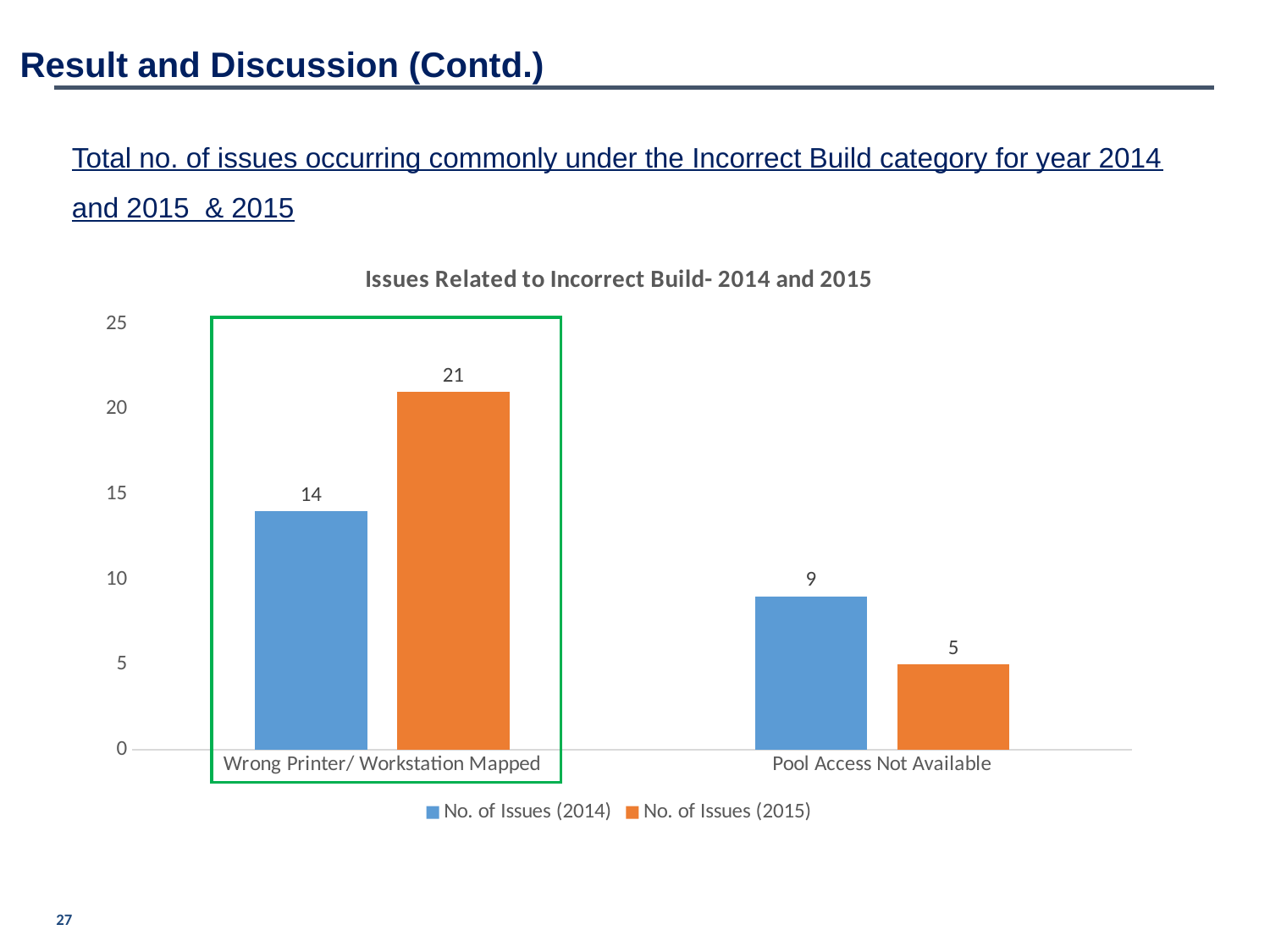
How many categories are shown on the x axis? 2 For Pool Access Not Available, which year had more issues, 2014 or 2015? 2014 What is the number of issues in 2014 for Pool Access Not Available? 9 What is the number of issues in 2015 for Pool Access Not Available? 5 What kind of chart is shown on the slide? Bar chart What is the number of issues in 2015 for Wrong Printer/ Workstation Mapped? 21 Which category has the lowest number of issues in 2014? Pool Access Not Available What is the title of the chart? Issues Related to Incorrect Build- 2014 and 2015 What is the difference between the 2015 and 2014 number of issues for Wrong Printer/ Workstation Mapped? 7 Which category has the highest number of issues in 2015? Wrong Printer/ Workstation Mapped How many series does the legend list? 2 What is the number of issues in 2014 for Wrong Printer/ Workstation Mapped? 14